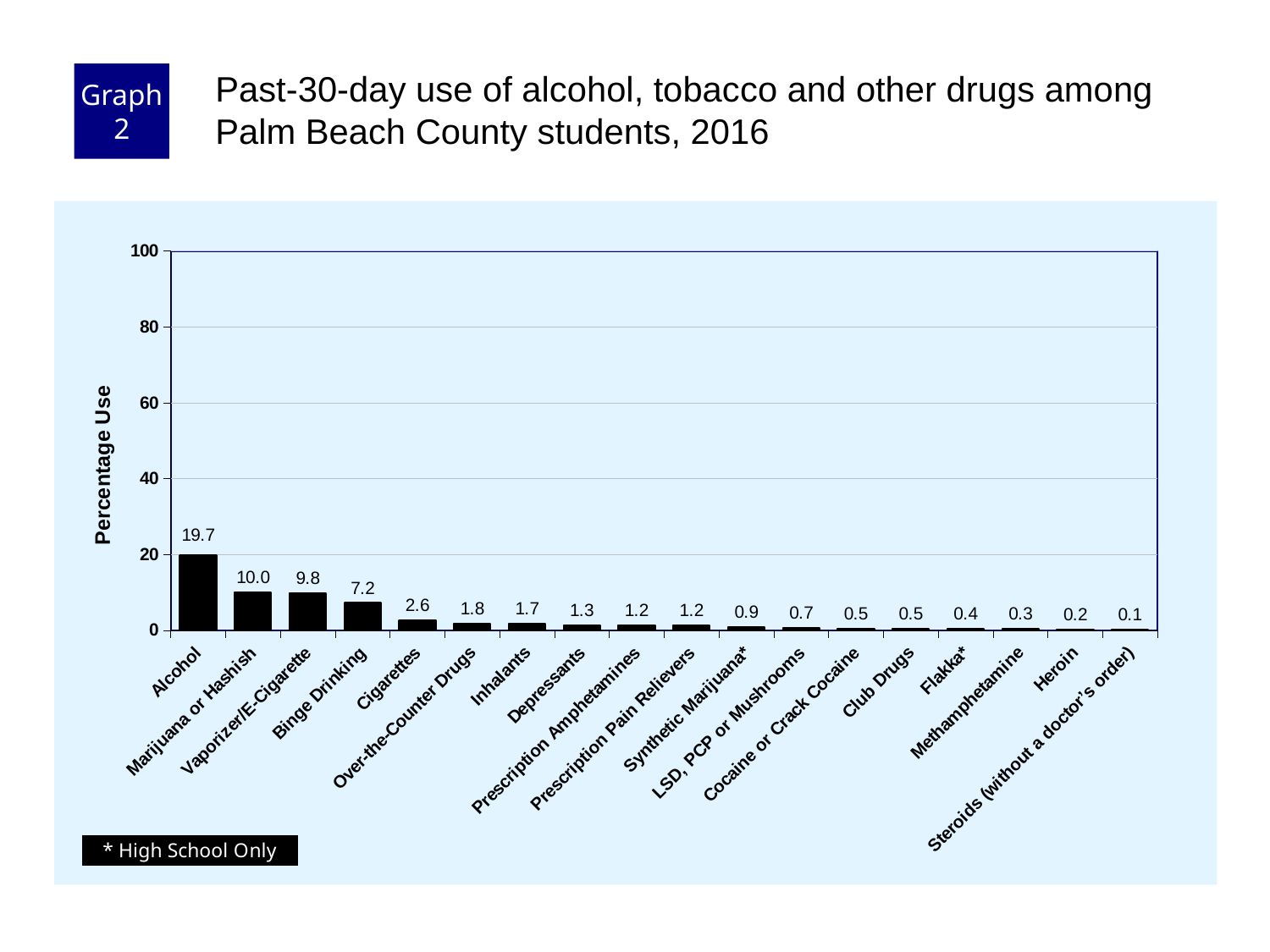
How many categories are shown on the x axis? 18 Which category has the lowest percentage use? Steroids (without a doctor's order) What is the percentage use for Heroin? 0.2 What is the percentage use for Binge Drinking? 7.2 What is the percentage use for Alcohol? 19.7 What is the difference in percentage use between Alcohol and Marijuana or Hashish? 9.7 Is the value for Alcohol greater or less than 40? less What kind of chart is shown on the slide? Bar chart What is the label of the y axis? Percentage Use What is the percentage use for Cigarettes? 2.6 Which category has the highest percentage use? Alcohol Which has a higher percentage use, Vaporizer/E-Cigarette or Binge Drinking? Vaporizer/E-Cigarette